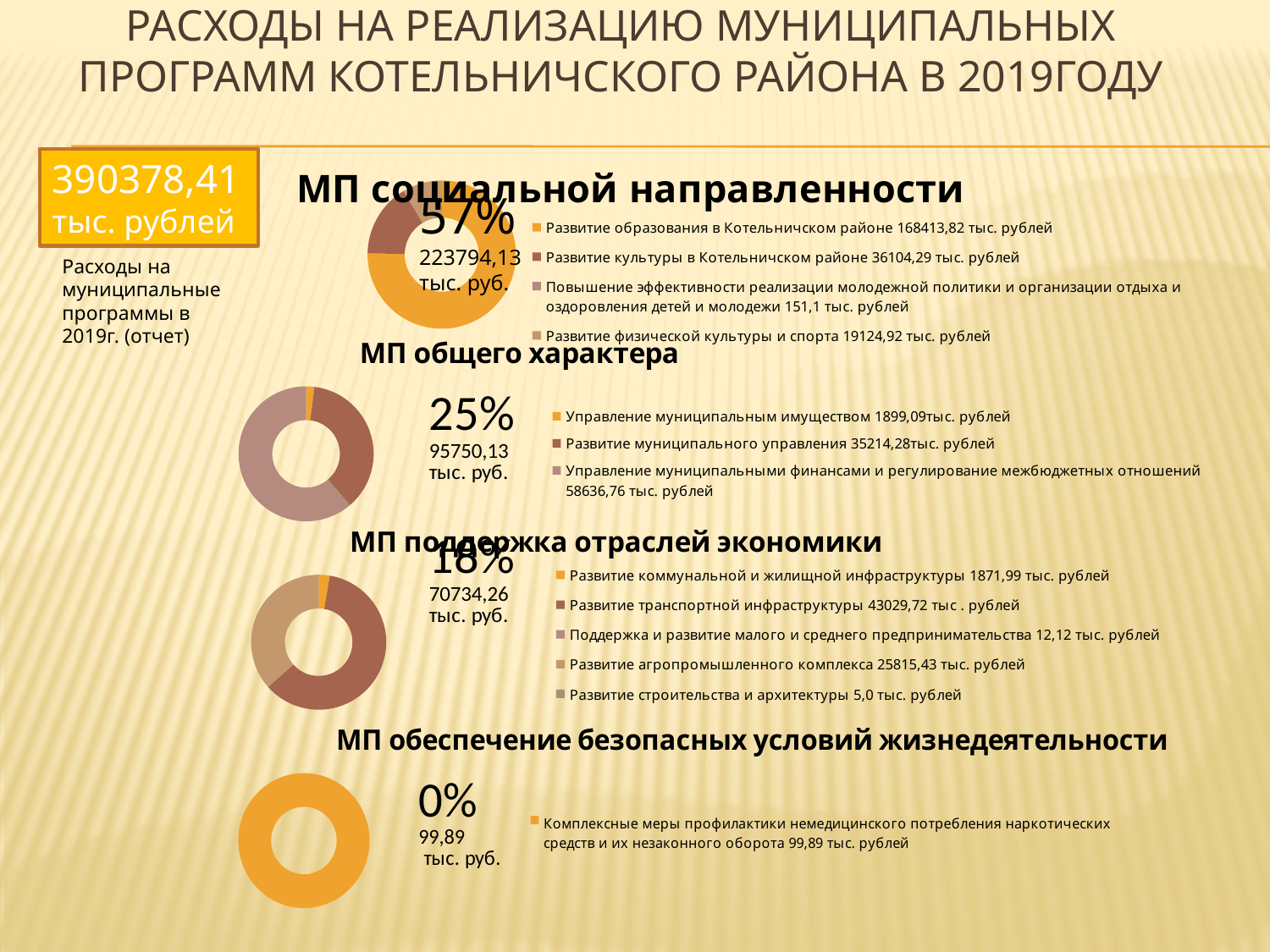
In the 'МП поддержка отраслей экономики' chart, what is the difference between 'Развитие транспортной инфраструктуры' and 'Развитие агропромышленного комплекса'? 17214,29 тыс. рублей In the 'МП поддержка отраслей экономики' chart, which is larger: 'Развитие коммунальной и жилищной инфраструктуры' or 'Поддержка и развитие малого и среднего предпринимательства'? Развитие коммунальной и жилищной инфраструктуры How many categories does the legend of the 'МП поддержка отраслей экономики' chart list? 5 In the 'МП общего характера' chart, what is the value for 'Развитие муниципального управления'? 35214,28 тыс. рублей How many doughnut charts are shown on the slide? 4 In the 'МП социальной направленности' chart, which category has the lowest value? Повышение эффективности реализации молодежной политики и организации отдыха и оздоровления детей и молодежи What percentage share is shown next to the 'МП общего характера' chart? 25% What total amount is shown next to the 'МП обеспечение безопасных условий жизнедеятельности' chart? 99,89 тыс. руб. In the 'МП общего характера' chart, which category has the highest value? Управление муниципальными финансами и регулирование межбюджетных отношений What kind of chart is used for 'МП социальной направленности'? Doughnut (pie) chart How many categories does the legend of the 'МП социальной направленности' chart list? 4 In the 'МП социальной направленности' chart, what is the value for 'Развитие образования в Котельничском районе'? 168413,82 тыс. рублей